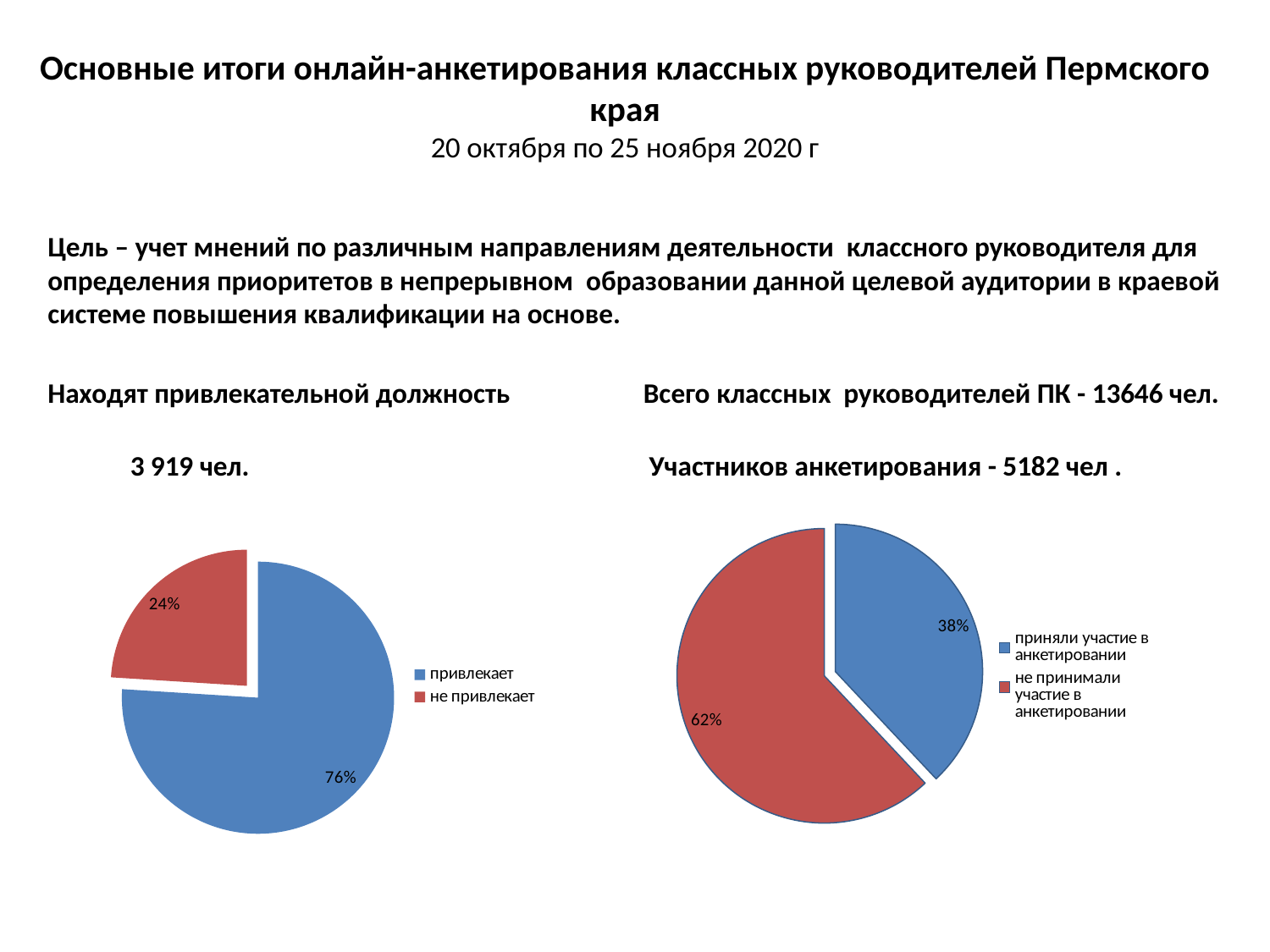
In the right pie chart, which is larger: 'приняли участие в анкетировании' or 'не принимали участие в анкетировании'? не принимали участие в анкетировании What type of chart is the left chart? pie chart In the right pie chart, what share took part in the survey (приняли участие в анкетировании)? 38% In the left pie chart, what share is labelled 'не привлекает'? 24% In the right pie chart, which slice is the smallest? приняли участие в анкетировании In the right pie chart, what is the difference in percentage points between those who did not take part and those who took part? 24 In the left pie chart, what share of respondents find the position attractive (привлекает)? 76% In the left pie chart, which slice is the largest? привлекает In the left pie chart, what is the difference in percentage points between 'привлекает' and 'не привлекает'? 52 How many slices does the right pie chart have? 2 In the left pie chart, what colour is the 'не привлекает' slice? red